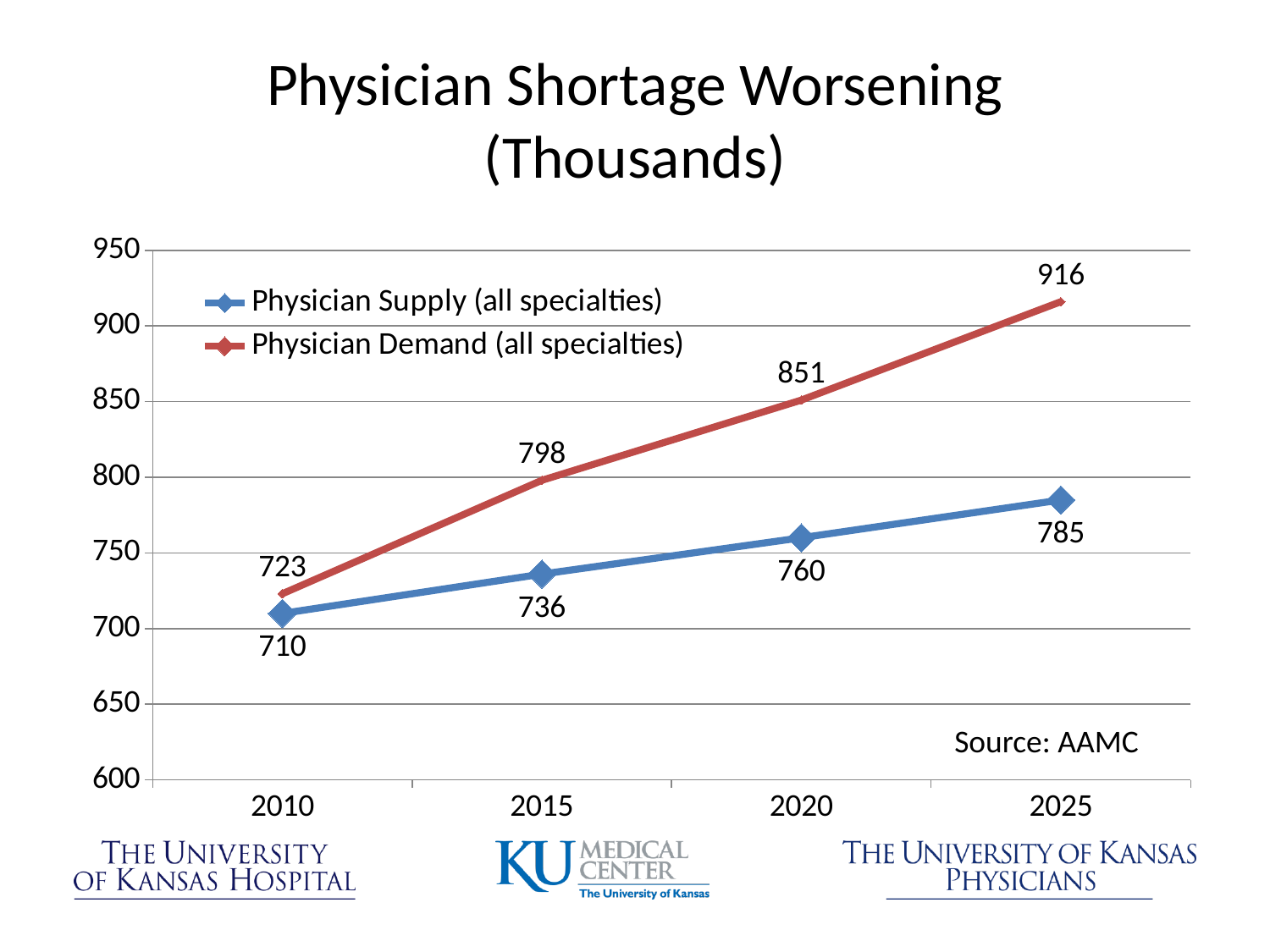
How many years are plotted on the x axis? 4 In which year is Physician Demand (all specialties) highest? 2025 Which is larger in 2015, Physician Supply or Physician Demand? Physician Demand What is the difference between Physician Demand and Physician Supply in 2020? 91 What is the Physician Supply (all specialties) value for 2010? 710 What kind of chart is shown on the slide? Line chart How many series does the legend list? 2 Do the Physician Supply (all specialties) values rise or fall from 2010 to 2025? Rise In which year is Physician Supply (all specialties) lowest? 2010 What is the difference between Physician Demand and Physician Supply in 2025? 131 What is the Physician Demand (all specialties) value for 2025? 916 What is the Physician Demand (all specialties) value for 2015? 798